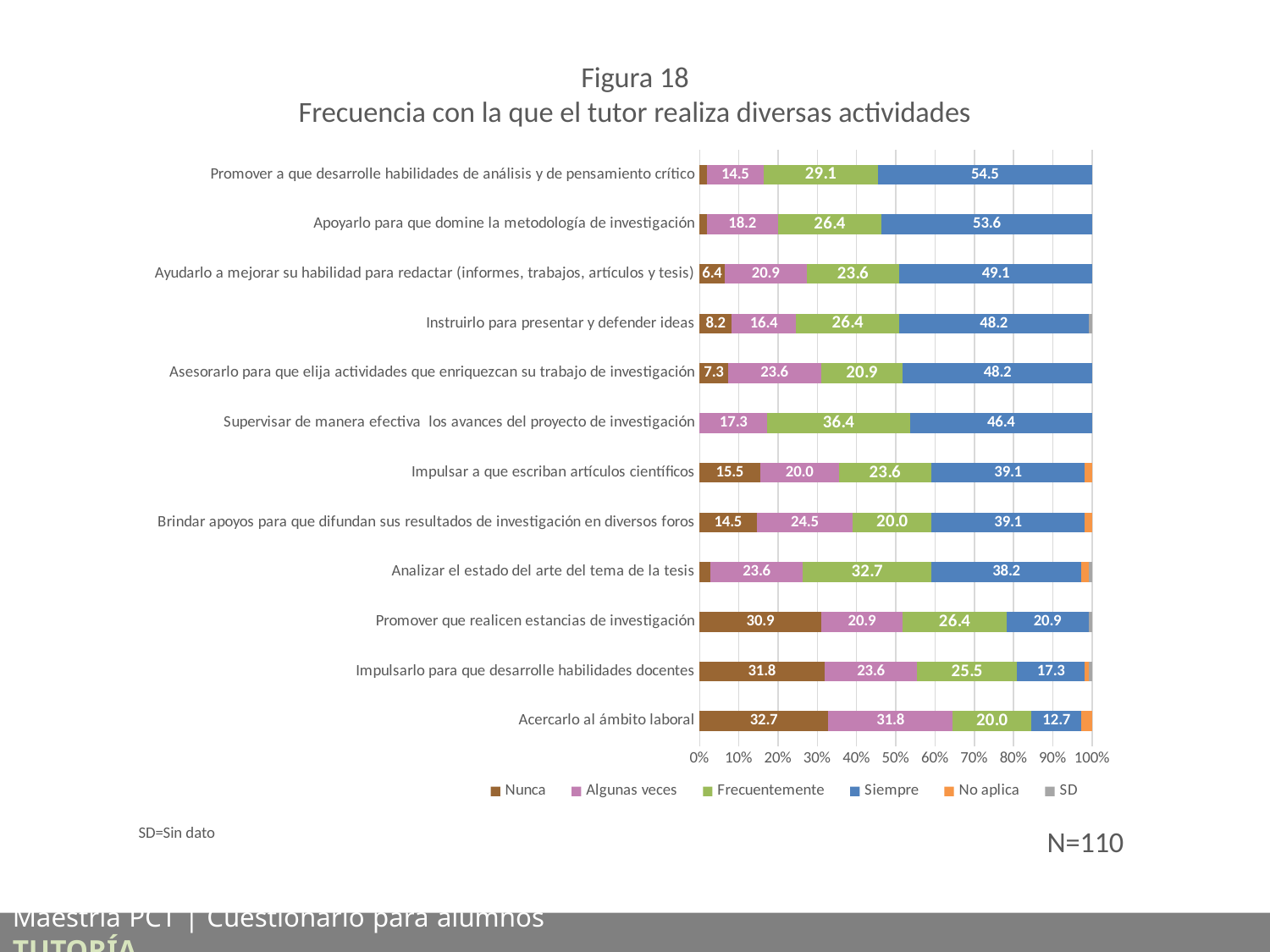
How many series does the legend list? 6 What is the value of the "Algunas veces" segment for "Brindar apoyos para que difundan sus resultados de investigación en diversos foros"? 24.5 What kind of chart is shown on the slide? Stacked bar chart How many activities (categories) are shown in the chart? 12 What is the value of the "Frecuentemente" segment for "Supervisar de manera efectiva los avances del proyecto de investigación"? 36.4 Which activity has the lowest "Siempre" value? Acercarlo al ámbito laboral What is the value of the "Nunca" segment for "Acercarlo al ámbito laboral"? 32.7 What is the value of the "Siempre" segment for "Promover a que desarrolle habilidades de análisis y de pensamiento crítico"? 54.5 Which has a larger "Siempre" value: "Instruirlo para presentar y defender ideas" or "Supervisar de manera efectiva los avances del proyecto de investigación"? Instruirlo para presentar y defender ideas What does the abbreviation SD stand for according to the note on the slide? Sin dato Which activity has the highest "Siempre" value? Promover a que desarrolle habilidades de análisis y de pensamiento crítico What is the difference between the "Frecuentemente" values for "Supervisar de manera efectiva los avances del proyecto de investigación" and "Analizar el estado del arte del tema de la tesis"? 3.7